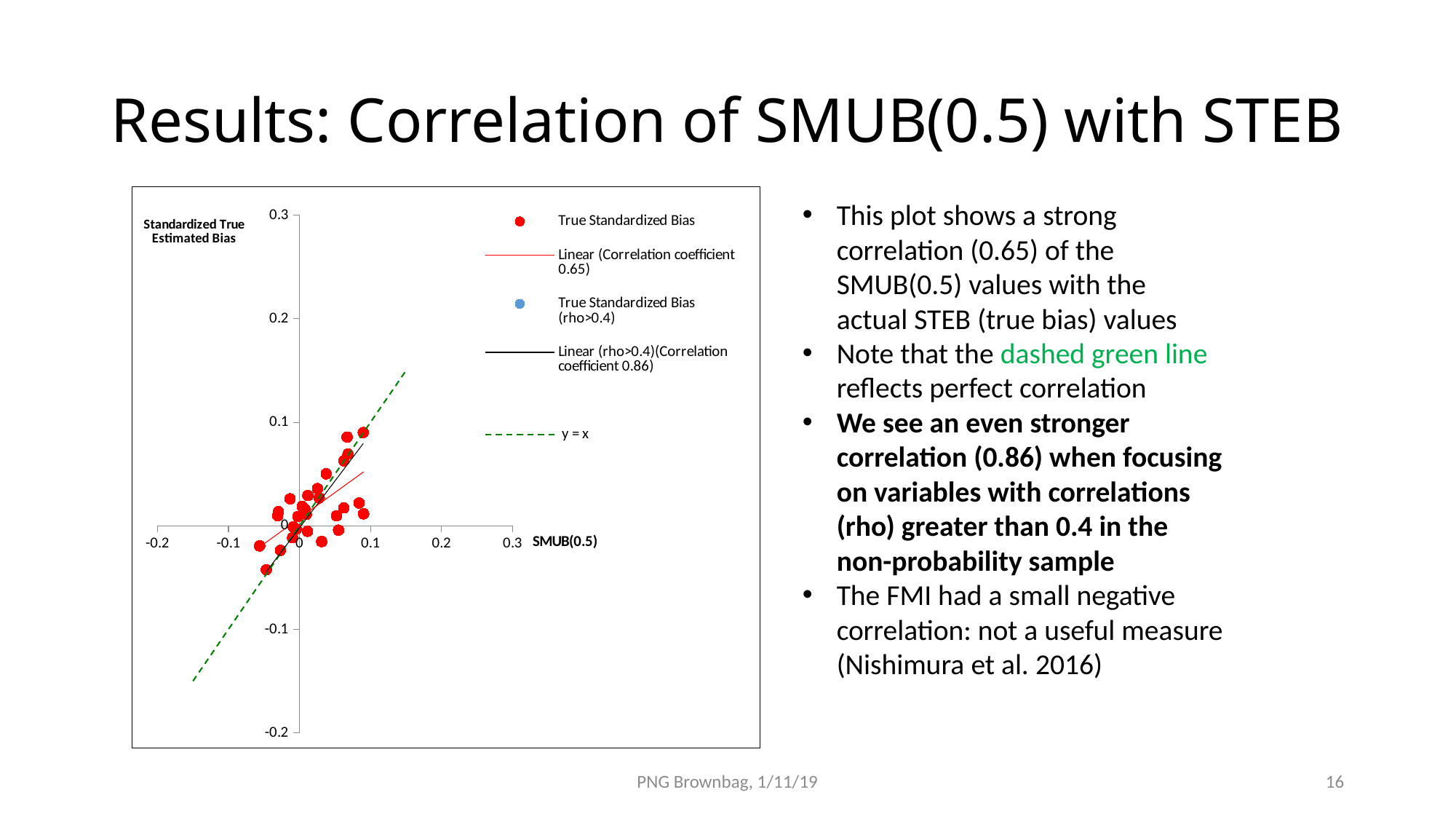
Do the plotted points generally rise or fall as SMUB(0.5) increases along the x axis? Rise What is the difference between the two correlation coefficients shown in the legend (0.86 and 0.65)? 0.21 What is the label of the vertical axis of the chart? Standardized True Estimated Bias Which of the two fitted linear trend lines has the larger correlation coefficient, the red line or the black (rho>0.4) line? The black (rho>0.4) line What is the highest tick value shown on the vertical axis? 0.3 What is the label of the horizontal axis of the chart? SMUB(0.5) How many entries does the chart's legend list? 5 Which legend entry corresponds to the dashed green line? y = x What correlation coefficient is given in the legend for the black linear trend line (rho>0.4)? 0.86 What is the lowest tick value shown on the horizontal axis? -0.2 What correlation coefficient is given in the legend for the red linear trend line? 0.65 What kind of chart is shown on the slide? Scatter plot